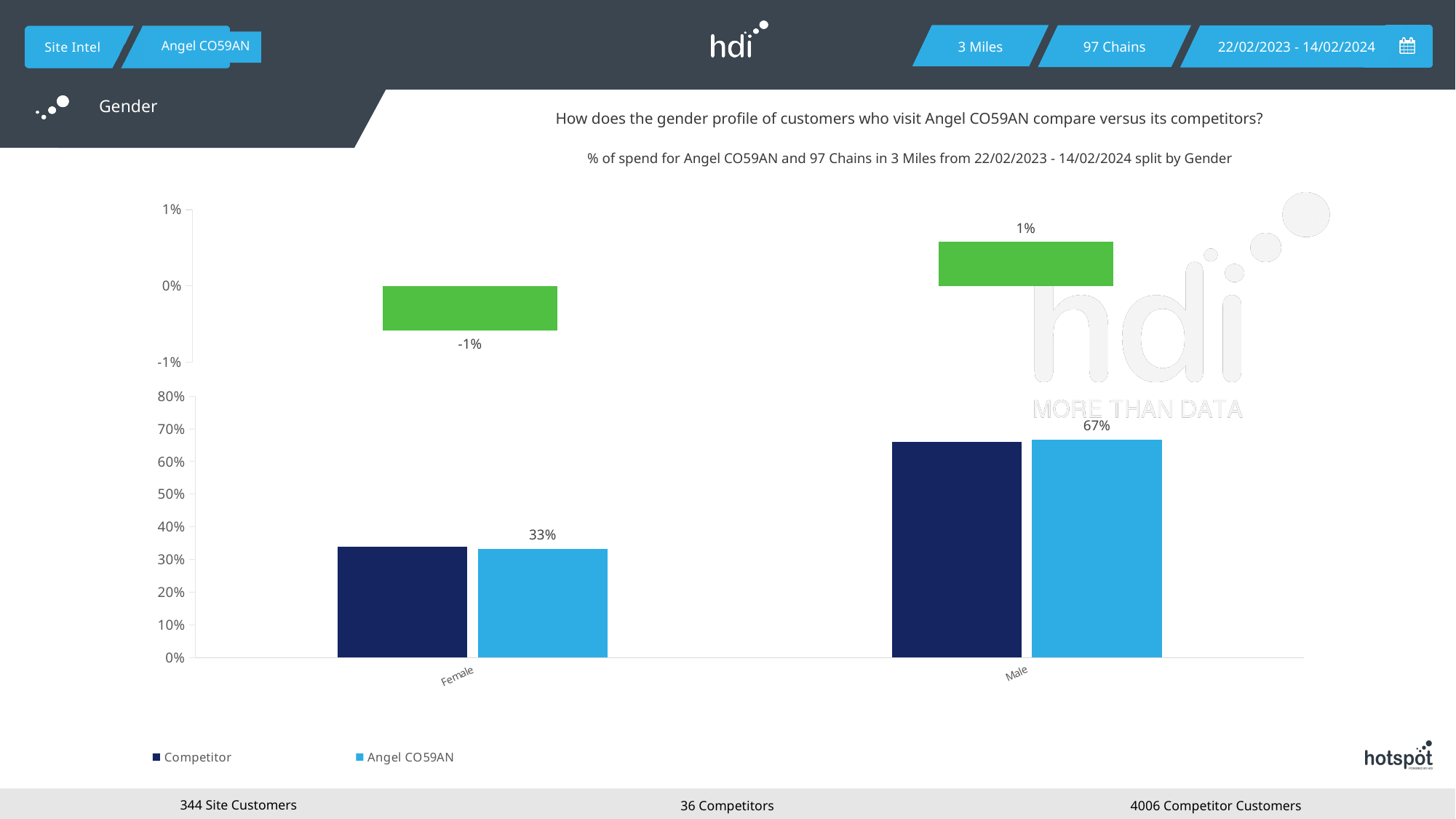
How many series does the legend of the bottom chart list? 2 In the bottom chart, what is the value for Angel CO59AN in the Female category? 33% What are the two series named in the legend of the bottom chart? Competitor and Angel CO59AN In the bottom chart, is the Competitor value for Male greater or less than 60%? greater What type of chart is the bottom chart? Bar chart In the top chart, what is the value shown for the Female category? -1% In the bottom chart, which category has the higher value for Angel CO59AN, Female or Male? Male In the bottom chart, what is the value for Angel CO59AN in the Male category? 67% In the bottom chart, is the Competitor value for Female greater or less than 40%? less In the bottom chart, how many categories are shown on the x axis? 2 In the bottom chart, what is the difference between the Angel CO59AN values for Male and Female? 34% In the top chart, what is the value shown for the Male category? 1%